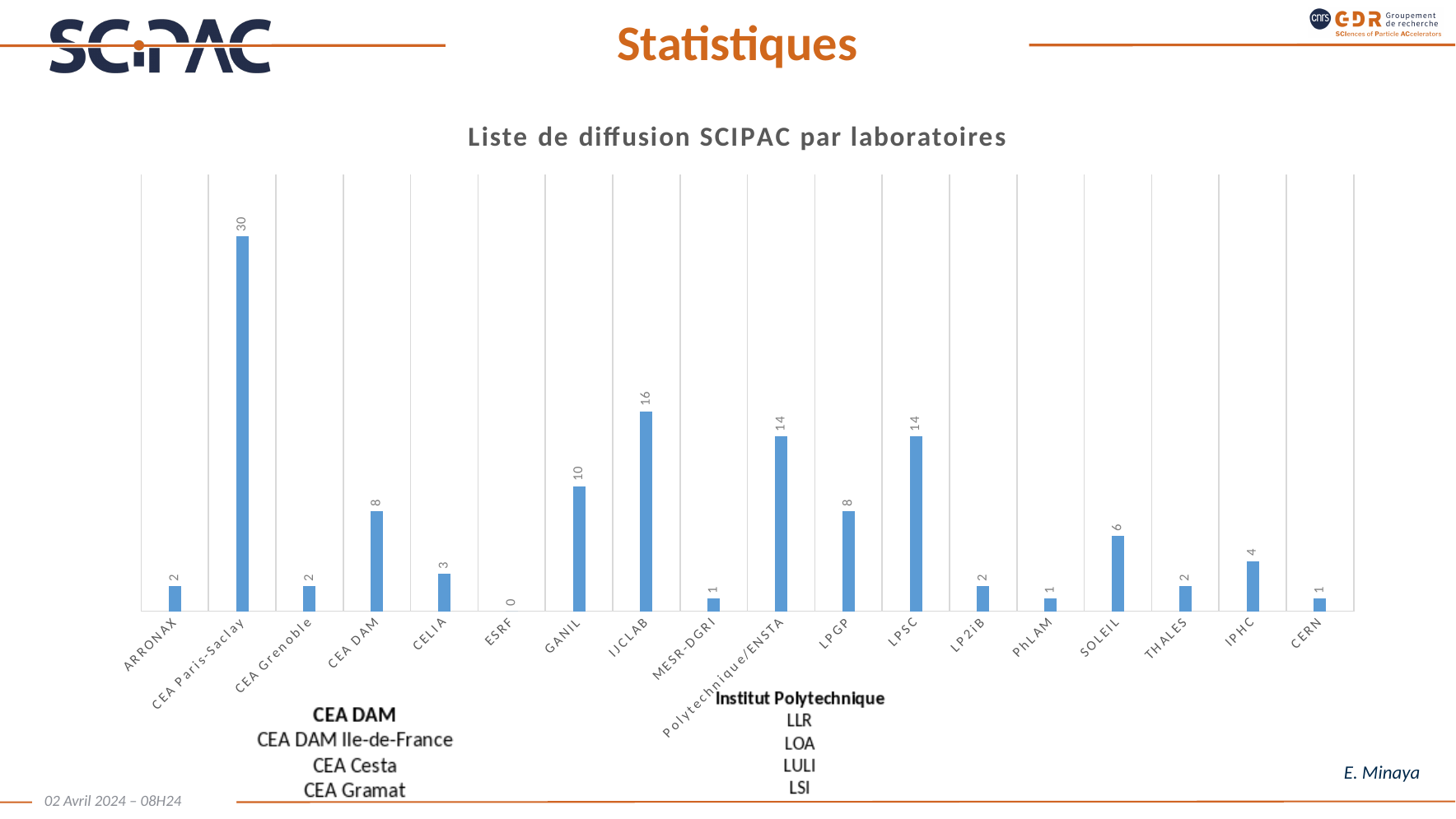
What is the title of the chart? Liste de diffusion SCIPAC par laboratoires What is the value for GANIL? 10 What is the difference between the values for GANIL and CEA DAM? 2 What kind of chart is shown on the slide? Bar chart Which laboratory has the lowest value? ESRF How many laboratories are shown on the x axis? 18 What is the difference between the values for CEA Paris-Saclay and IJCLAB? 14 What is the value for IJCLAB? 16 What is the value for CEA Paris-Saclay? 30 What is the value for SOLEIL? 6 Which is larger, the value for LPSC or the value for LPGP? LPSC Which laboratory has the highest value? CEA Paris-Saclay